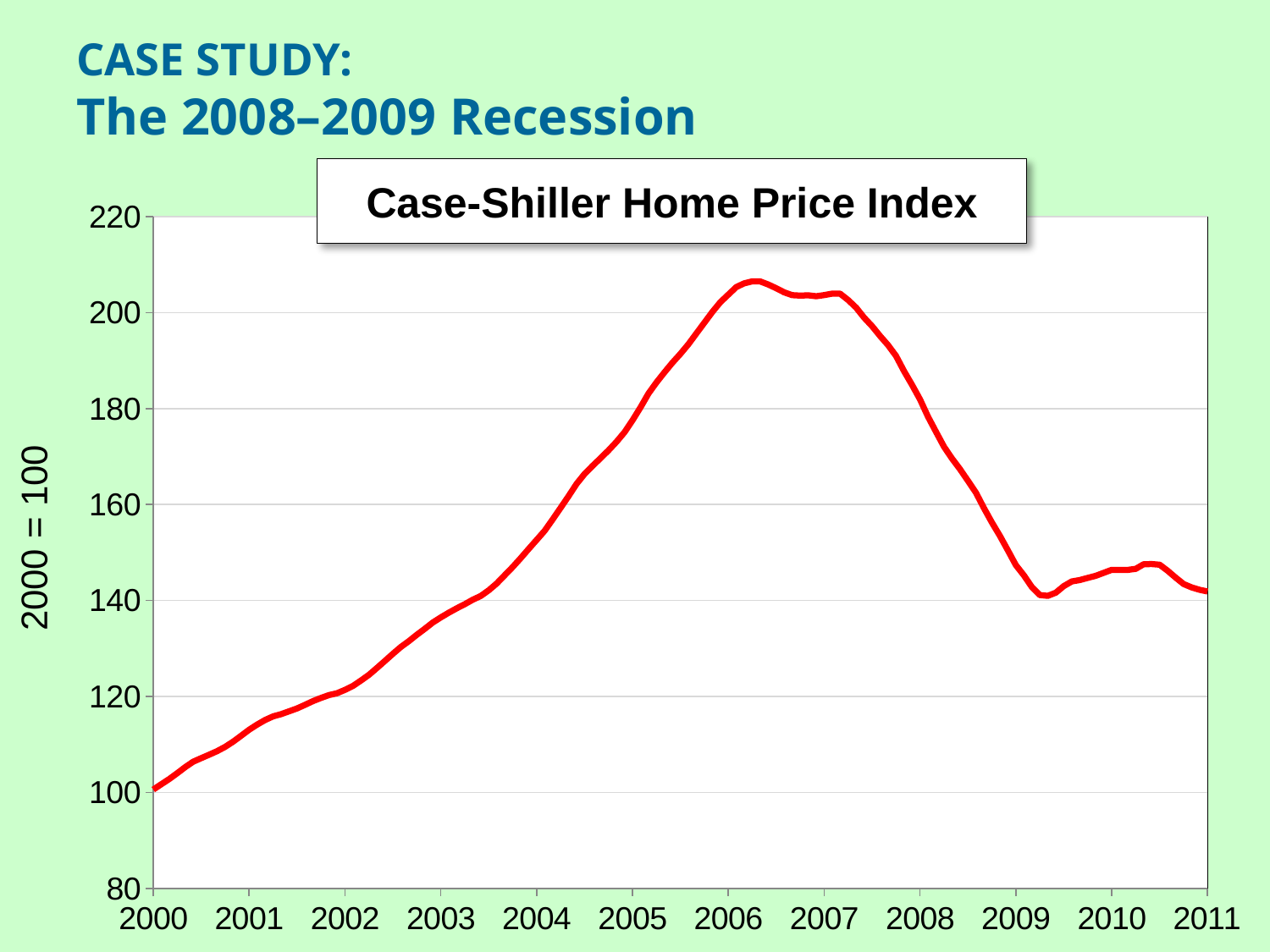
Is the value of the index at 2008 greater or less than 180? greater Does the index rise or fall between 2000 and 2006? rise Does the index rise or fall between 2007 and 2009? fall Is the value of the index at 2001 greater or less than 120? less Which is larger, the index value at 2006 or at 2010? 2006 What is the label on the vertical axis of the chart? 2000 = 100 What is the title of the chart? Case-Shiller Home Price Index What kind of chart is shown on the slide? line chart Is the value of the index at 2003 greater or less than 140? less